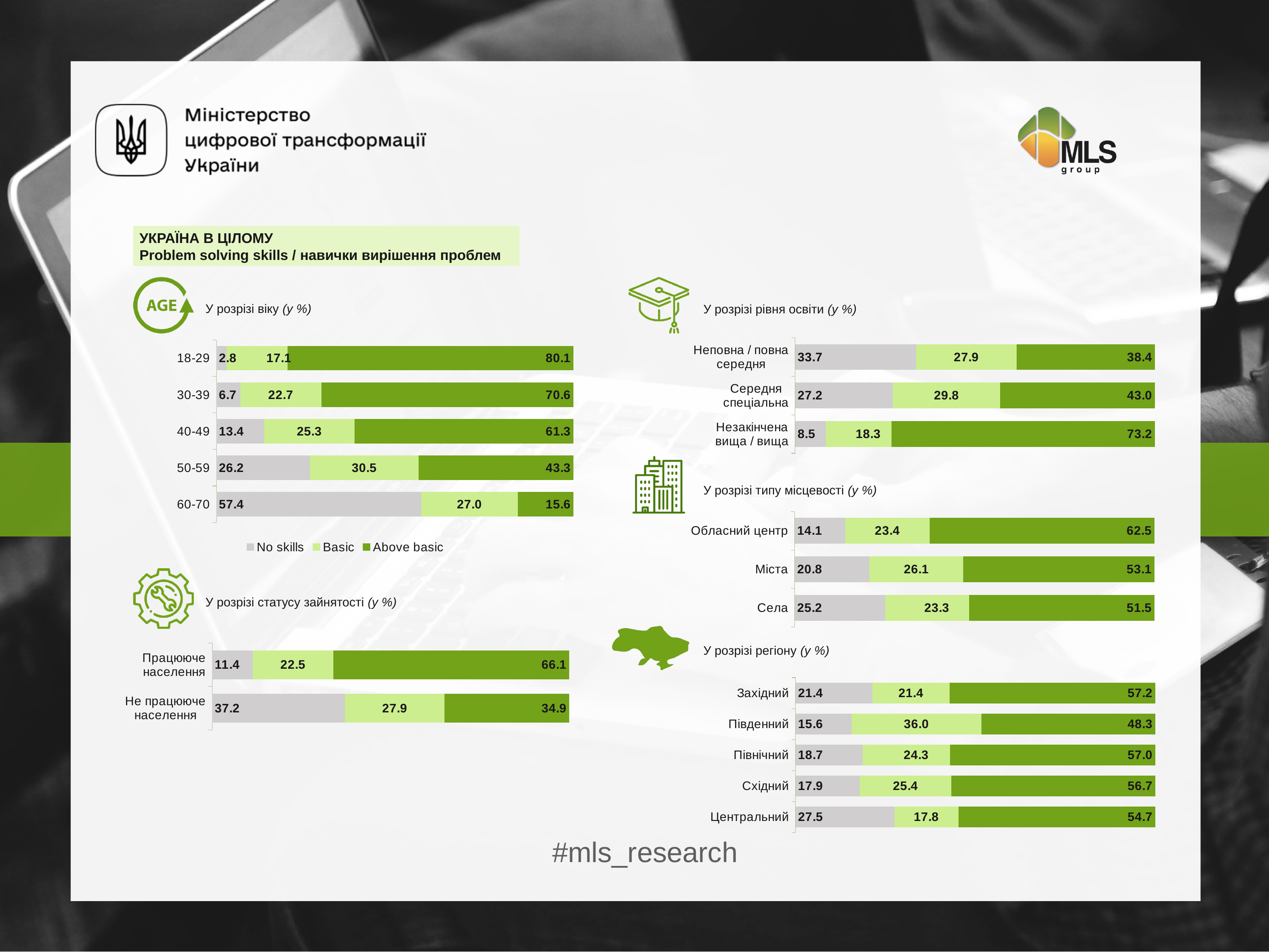
In the chart 'У розрізі рівня освіти (у %)', which education level has the lowest 'No skills' value? Незакінчена вища / вища In the chart 'У розрізі віку (у %)', how many age groups are shown? 5 In the chart 'У розрізі віку (у %)', what is the difference between the 'Above basic' values for 18-29 and 30-39? 9.5 How many series does the legend under the chart 'У розрізі віку (у %)' list? 3 In the chart 'У розрізі віку (у %)', what is the 'Above basic' value for the 18-29 age group? 80.1 In the chart 'У розрізі віку (у %)', which age group has the highest 'No skills' value? 60-70 In the chart 'У розрізі рівня освіти (у %)', what is the 'Basic' value for 'Середня спеціальна'? 29.8 In the chart 'У розрізі типу місцевості (у %)', which is larger: the 'Above basic' value for 'Обласний центр' or for 'Села'? Обласний центр What kind of chart is 'У розрізі рівня освіти (у %)'? Stacked bar chart In the chart 'У розрізі регіону (у %)', what is the total of the stacked bar for 'Центральний'? 100.0 In the chart 'У розрізі регіону (у %)', which region has the highest 'Basic' value? Південний In the chart 'У розрізі статусу зайнятості (у %)', what is the 'No skills' value for 'Не працююче населення'? 37.2